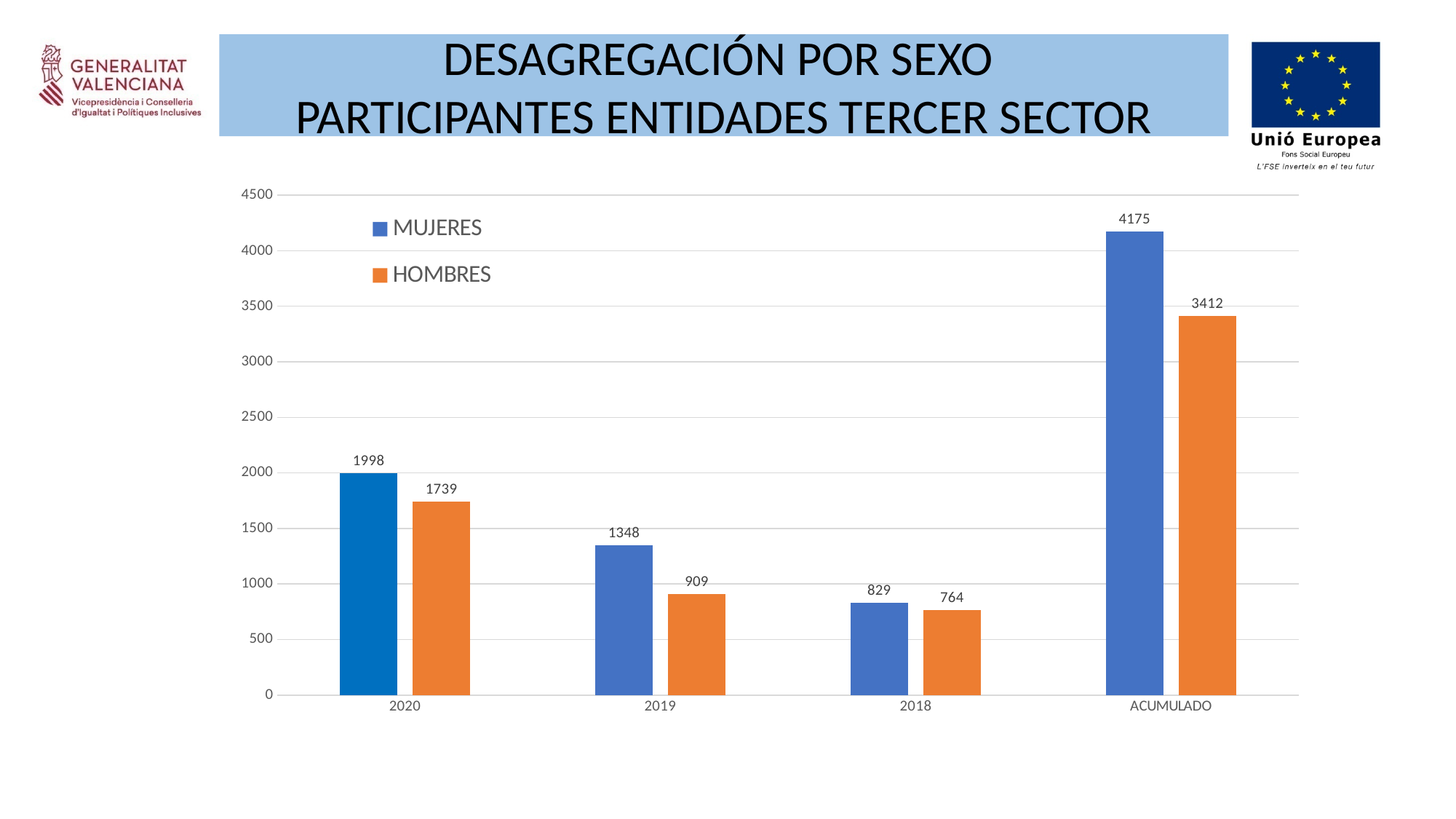
What is the value for HOMBRES in 2019? 909 Which is larger in 2018, MUJERES or HOMBRES? MUJERES Is the value for MUJERES in ACUMULADO greater or less than 4000? greater What is the value for HOMBRES in ACUMULADO? 3412 What kind of chart is shown on the slide? bar chart Which category has the highest MUJERES value? ACUMULADO How many series does the legend list? 2 What is the difference between MUJERES and HOMBRES in 2020? 259 How many categories are shown on the x axis? 4 What is the value for MUJERES in 2020? 1998 Which colour represents HOMBRES in the legend? orange Which category has the lowest HOMBRES value? 2018